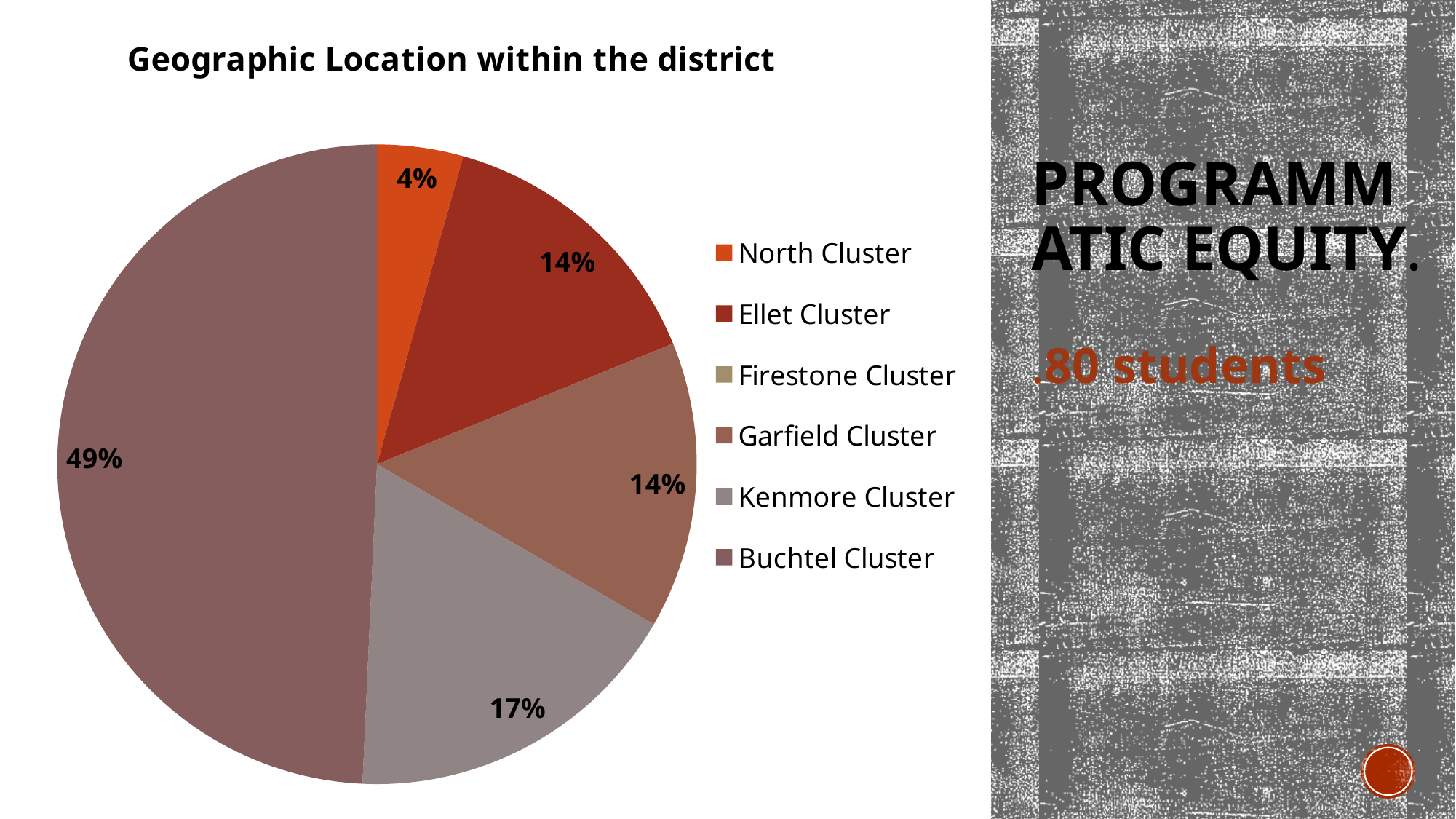
What is the difference in percentage points between the Buchtel Cluster and the Kenmore Cluster? 32 What kind of chart is shown on the slide? pie chart How many clusters does the legend list? 6 What is the difference in percentage points between the Kenmore Cluster and the North Cluster? 13 What percentage of the pie is the Garfield Cluster? 14% Which is larger, the Kenmore Cluster share or the Ellet Cluster share? Kenmore Cluster What percentage of the pie is the North Cluster? 4% Which cluster has the largest share of the pie? Buchtel Cluster What is the title of the chart? Geographic Location within the district What percentage of the pie is the Ellet Cluster? 14% What percentage of the pie is the Buchtel Cluster? 49% What percentage of the pie is the Kenmore Cluster? 17%